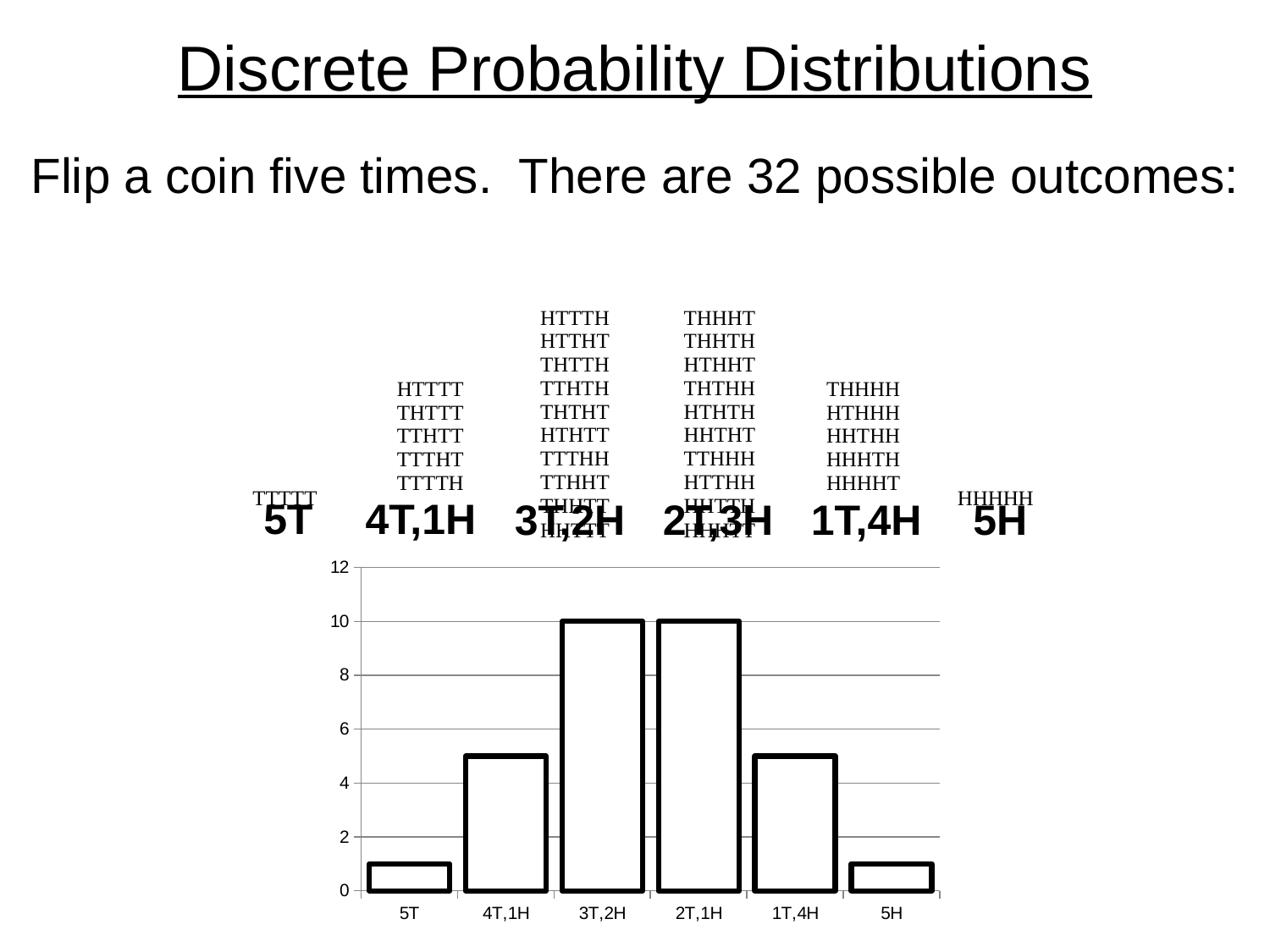
Which is larger, the bar for 2T,1H or the bar for 1T,4H? 2T,1H Is the value for 4T,1H greater or less than 4? greater Do the bar values rise or fall from 5T to 3T,2H along the x axis? rise What kind of chart is shown on the slide? bar chart Is the value for 1T,4H greater or less than 6? less What is the value of the bar for 3T,2H? 10 Which is larger, the bar for 4T,1H or the bar for 5T? 4T,1H What is the value of the bar for 2T,1H? 10 What is the highest value shown on the y axis of the chart? 12 Is the value for 5T greater or less than 2? less How many categories are shown on the x axis of the chart? 6